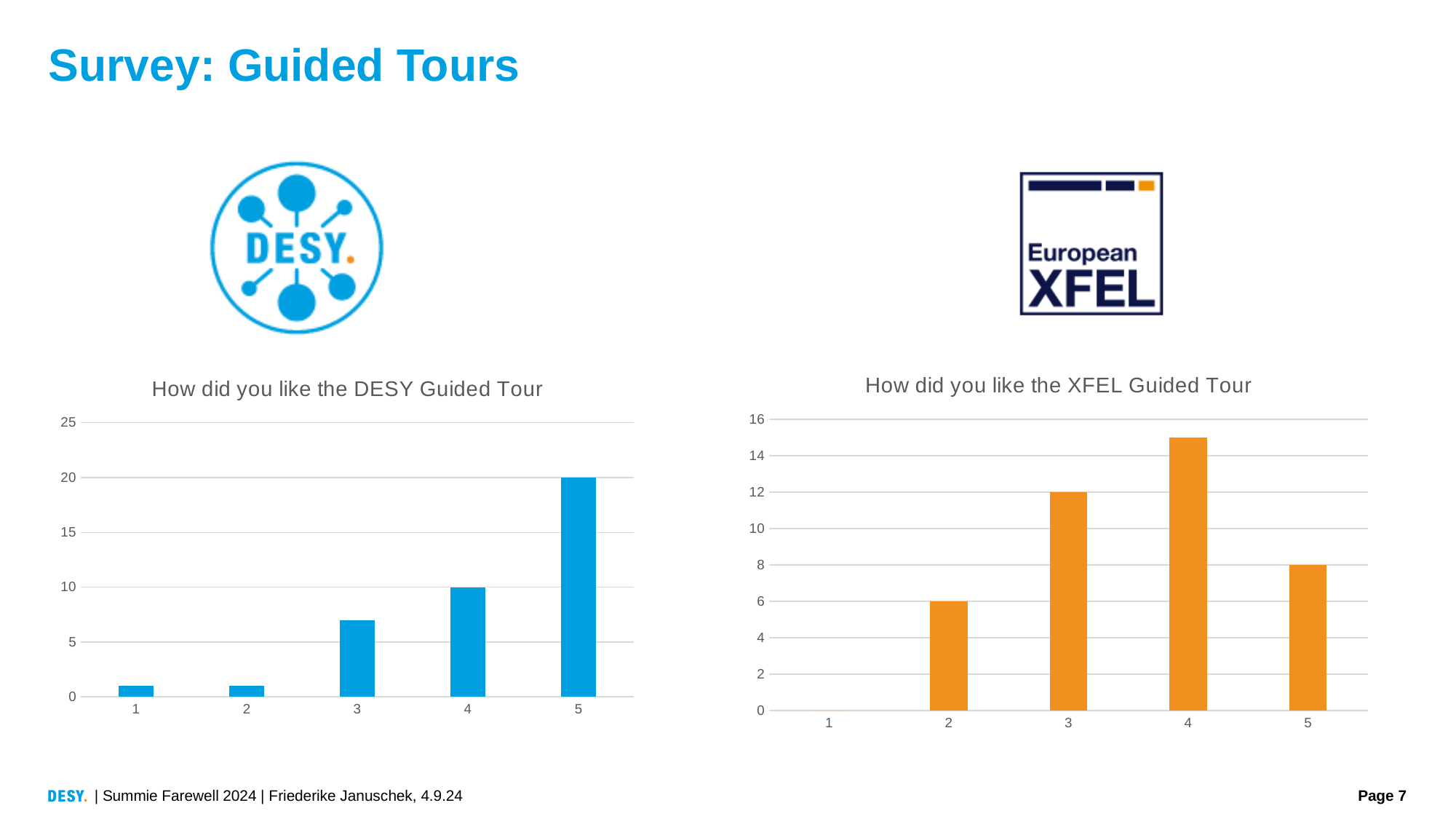
In the chart titled "How did you like the XFEL Guided Tour", what is the value for rating 5? 8 In the chart titled "How did you like the XFEL Guided Tour", which rating has the highest value? 4 In the chart titled "How did you like the DESY Guided Tour", what is the difference between the values for rating 5 and rating 4? 10 In the chart titled "How did you like the XFEL Guided Tour", what is the value for rating 3? 12 In the chart titled "How did you like the XFEL Guided Tour", what is the value for rating 2? 6 What kind of chart is the one titled "How did you like the XFEL Guided Tour"? bar chart In the chart titled "How did you like the DESY Guided Tour", what is the value for rating 5? 20 In the chart titled "How did you like the DESY Guided Tour", which rating has the highest value? 5 In the chart titled "How did you like the DESY Guided Tour", what is the value for rating 4? 10 In the chart titled "How did you like the XFEL Guided Tour", is the value for rating 4 greater or less than 14? greater In the chart titled "How did you like the DESY Guided Tour", is the value for rating 3 greater or less than 5? greater In the chart titled "How did you like the XFEL Guided Tour", what is the difference between the values for rating 3 and rating 5? 4